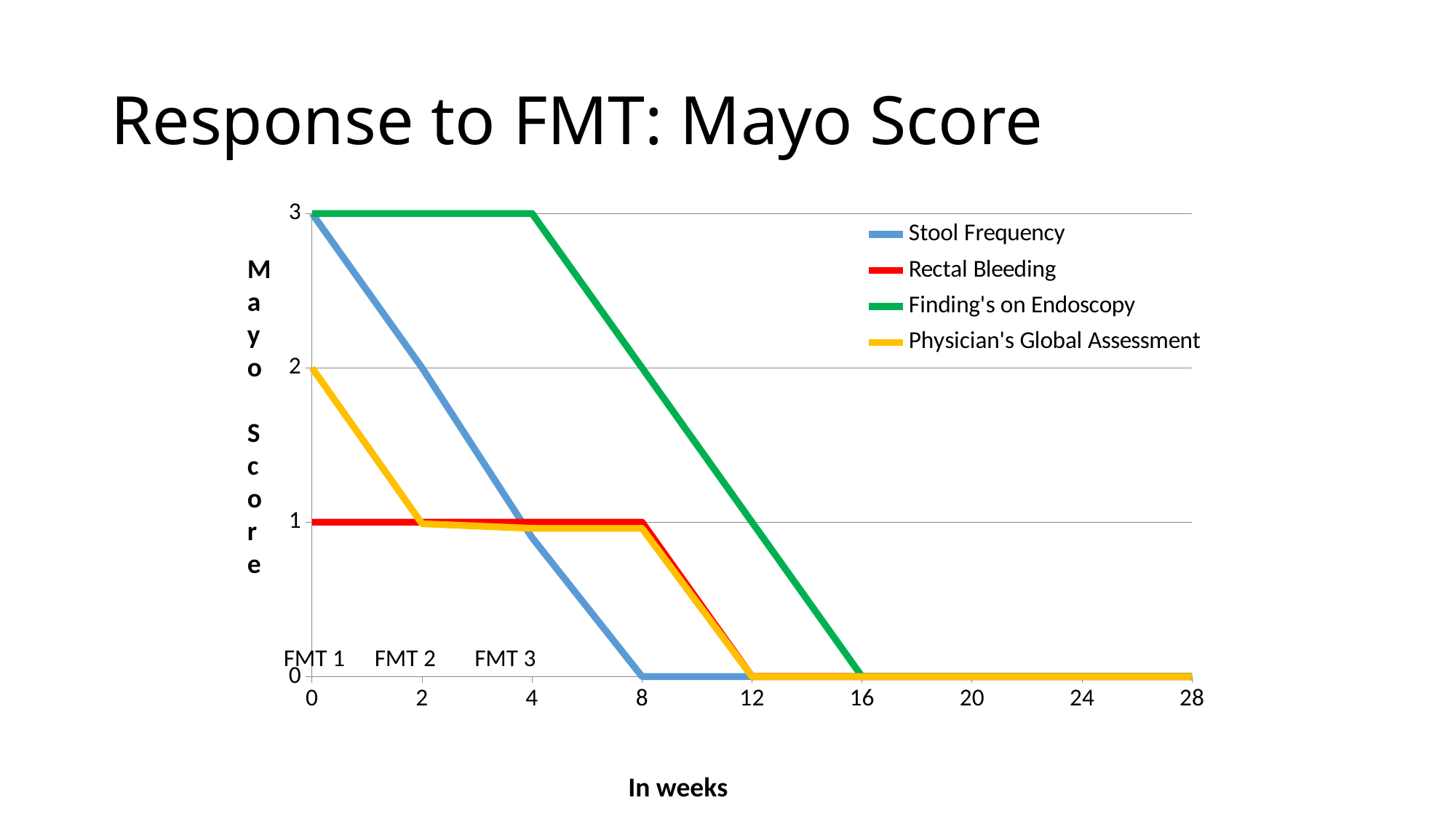
Which series has the highest Mayo Score at week 8? Finding's on Endoscopy At which week does Stool Frequency first reach a Mayo Score of 0? 8 What is the Mayo Score for Physician's Global Assessment at week 0? 2 Do the Mayo Scores rise or fall over the weeks shown? fall At which week does Finding's on Endoscopy first reach a Mayo Score of 0? 16 How many series does the legend list? 4 What is the difference between the Stool Frequency score and the Rectal Bleeding score at week 0? 2 What is the Mayo Score for Rectal Bleeding at week 0? 1 What is the Mayo Score for Finding's on Endoscopy at week 4? 3 What is the Mayo Score for Stool Frequency at week 0? 3 What kind of chart is shown on the slide? line chart Which series has the lowest Mayo Score at week 0? Rectal Bleeding